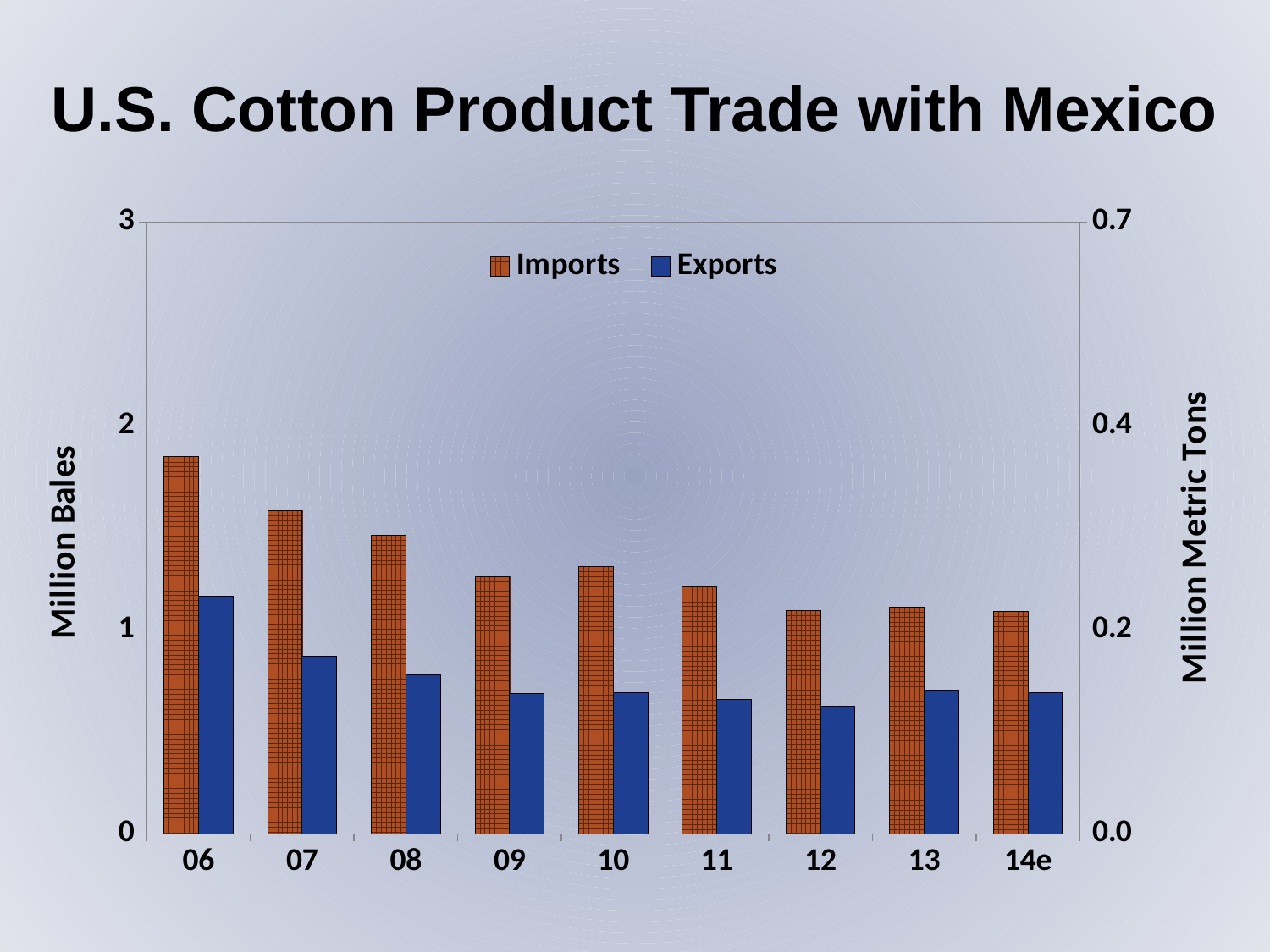
Is the Exports value for 12 greater or less than 1 million bales? less Is the Imports value for 09 greater or less than 1 million bales? greater How many series does the legend list? 2 Which year has the highest Exports value? 06 What is the label on the left vertical axis? Million Bales Is the Exports value for 06 greater or less than 1 million bales? greater What kind of chart is shown on the slide? Bar chart Which year has the highest Imports value? 06 How many years are shown along the x axis? 9 In 06, which is larger, Imports or Exports? Imports Do Imports generally rise or fall from 06 to 14e? Fall